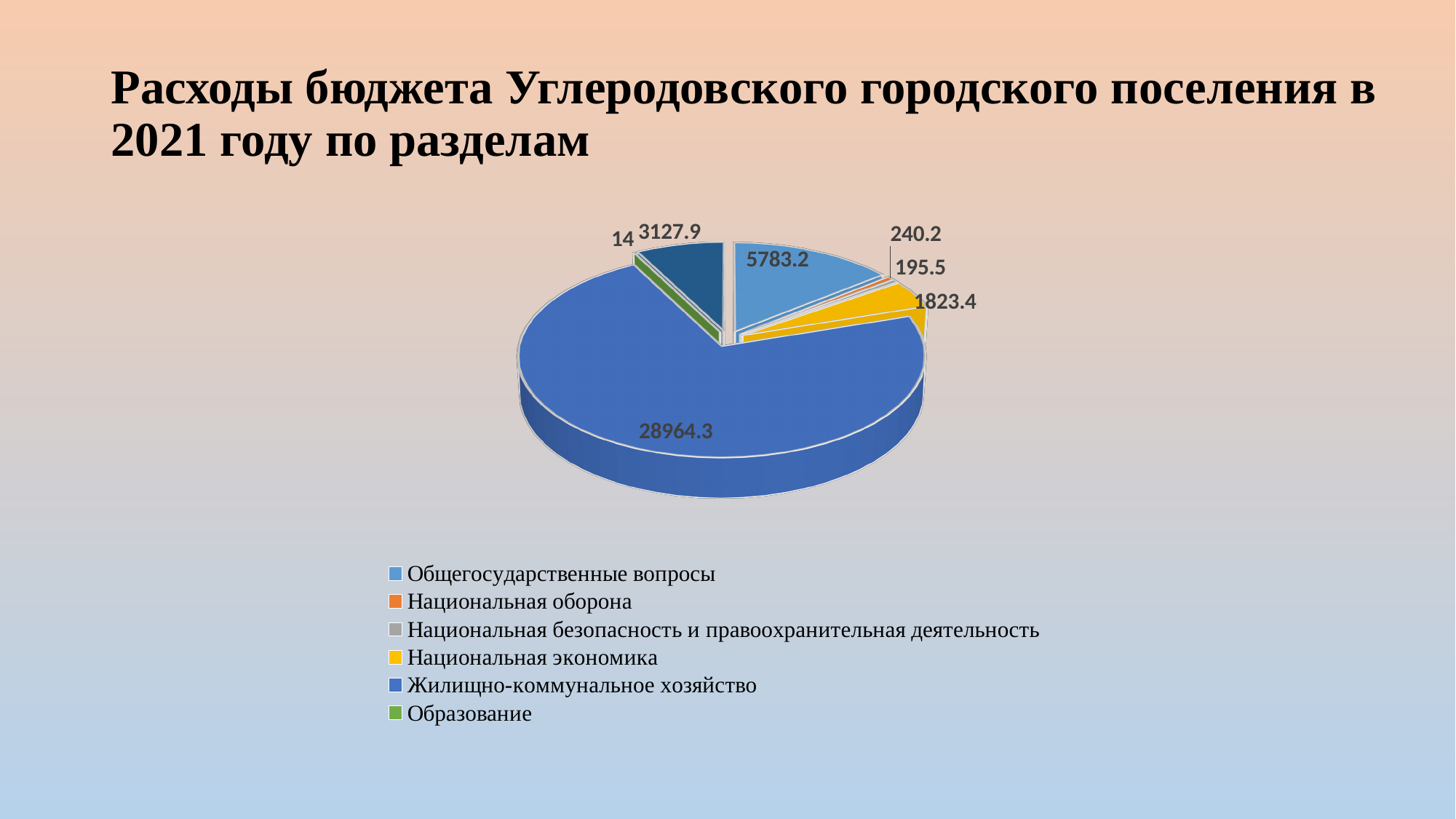
Which is larger: Национальная оборона or Национальная безопасность и правоохранительная деятельность? Национальная оборона What kind of chart is shown on the slide? Pie chart Which section has the smallest expenditure? Образование What is the value for Общегосударственные вопросы? 5783.2 What is the value for Национальная оборона? 240.2 What is the value for Жилищно-коммунальное хозяйство? 28964.3 Which section has the largest expenditure? Жилищно-коммунальное хозяйство How many entries does the legend list? 6 What is the difference between Общегосударственные вопросы and Национальная экономика? 3959.8 What is the value for Национальная экономика? 1823.4 What is the value for Образование? 14 What is the title of the chart slide? Расходы бюджета Углеродовского городского поселения в 2021 году по разделам